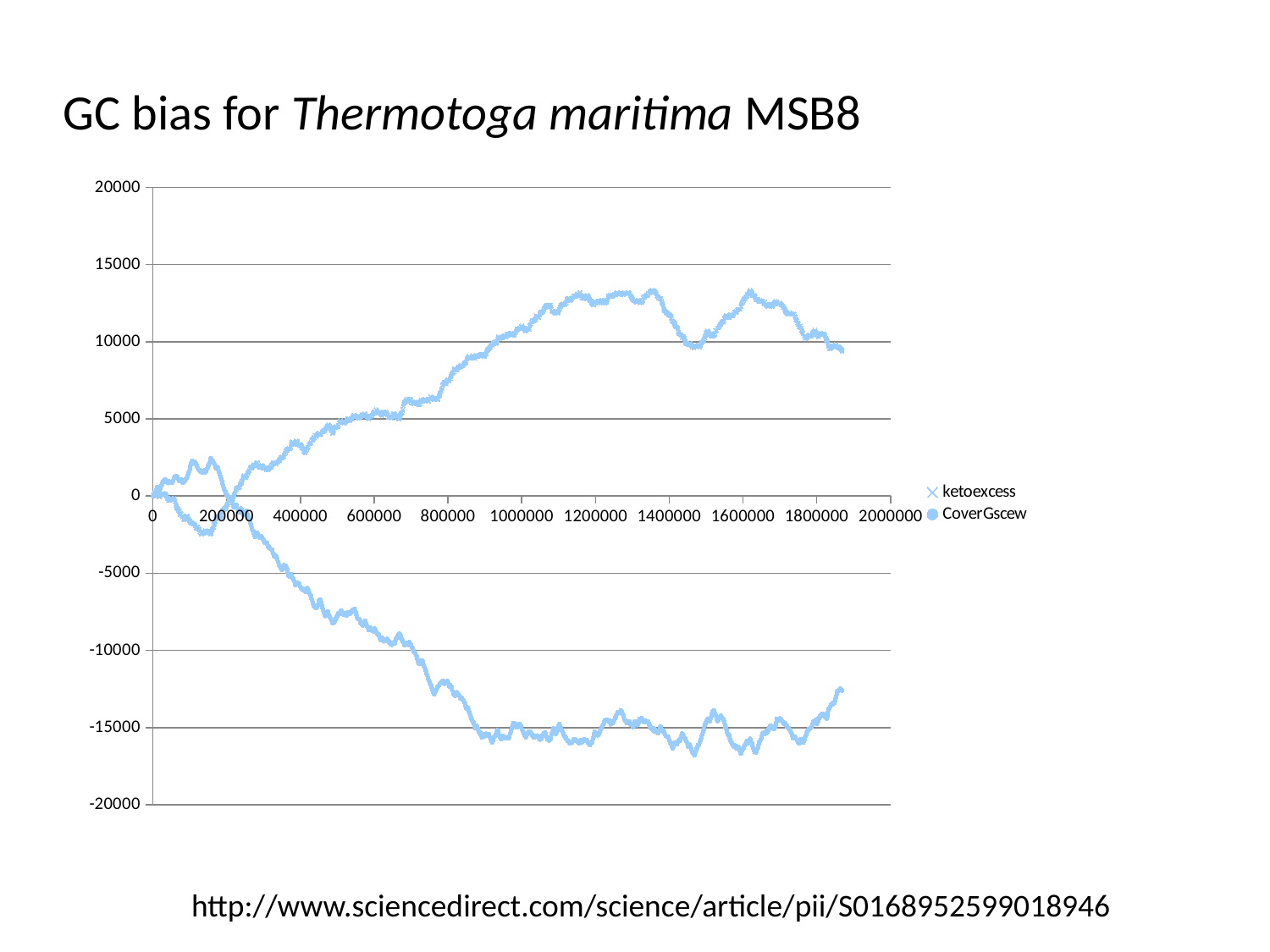
Is the highest point reached by the upper curve greater or less than 10000? greater Is the lowest point reached by the lower curve greater or less than -20000? greater Does the upper curve overall rise or fall as the x value increases from 0 to about 1800000? rise Does the lower curve overall rise or fall as the x value increases from 0 to about 1000000? fall How many series does the legend list? 2 What is the title of the slide containing the chart? GC bias for Thermotoga maritima MSB8 What are the two series named in the legend? ketoexcess and CoverGscew Is the highest point reached by the upper curve greater or less than 15000? less What kind of chart is shown on the slide? scatter chart What is the maximum value shown on the x axis? 2000000 What is the maximum value shown on the y axis? 20000